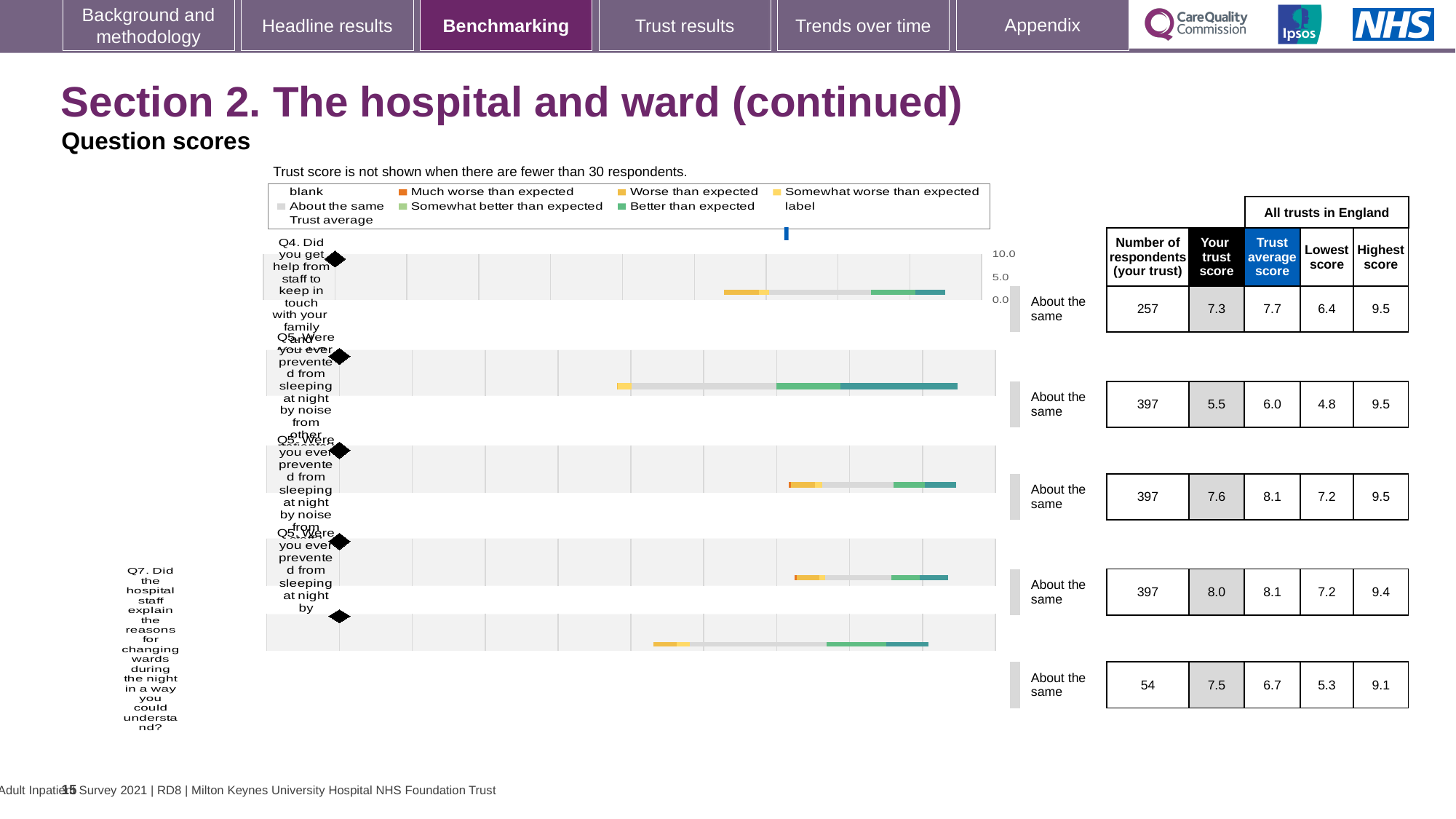
What is the highest 'Your trust score' value shown in the table? 8.0 What is the highest tick value shown on the chart's score axis? 10.0 What kind of chart is used to show the question scores on this slide? bar chart What is the trust average score for Q7 (explaining reasons for changing wards during the night)? 6.7 What is the difference between the highest score and the lowest score for Q4? 3.1 According to the table, what is the trust score for Q4 (help from staff to keep in touch with family and friends)? 7.3 According to the table, how many respondents answered Q7 (explaining reasons for changing wards during the night)? 54 What is the lowest 'Your trust score' value shown in the table? 5.5 Is the trust score for Q4 greater or less than 5.0 on the chart axis? greater For Q7, which is larger: the trust's own score or the trust average score? Your trust score (7.5) For Q4, which is larger: the trust's own score or the trust average score? Trust average score (7.7) How many question bars are plotted in the chart? 5